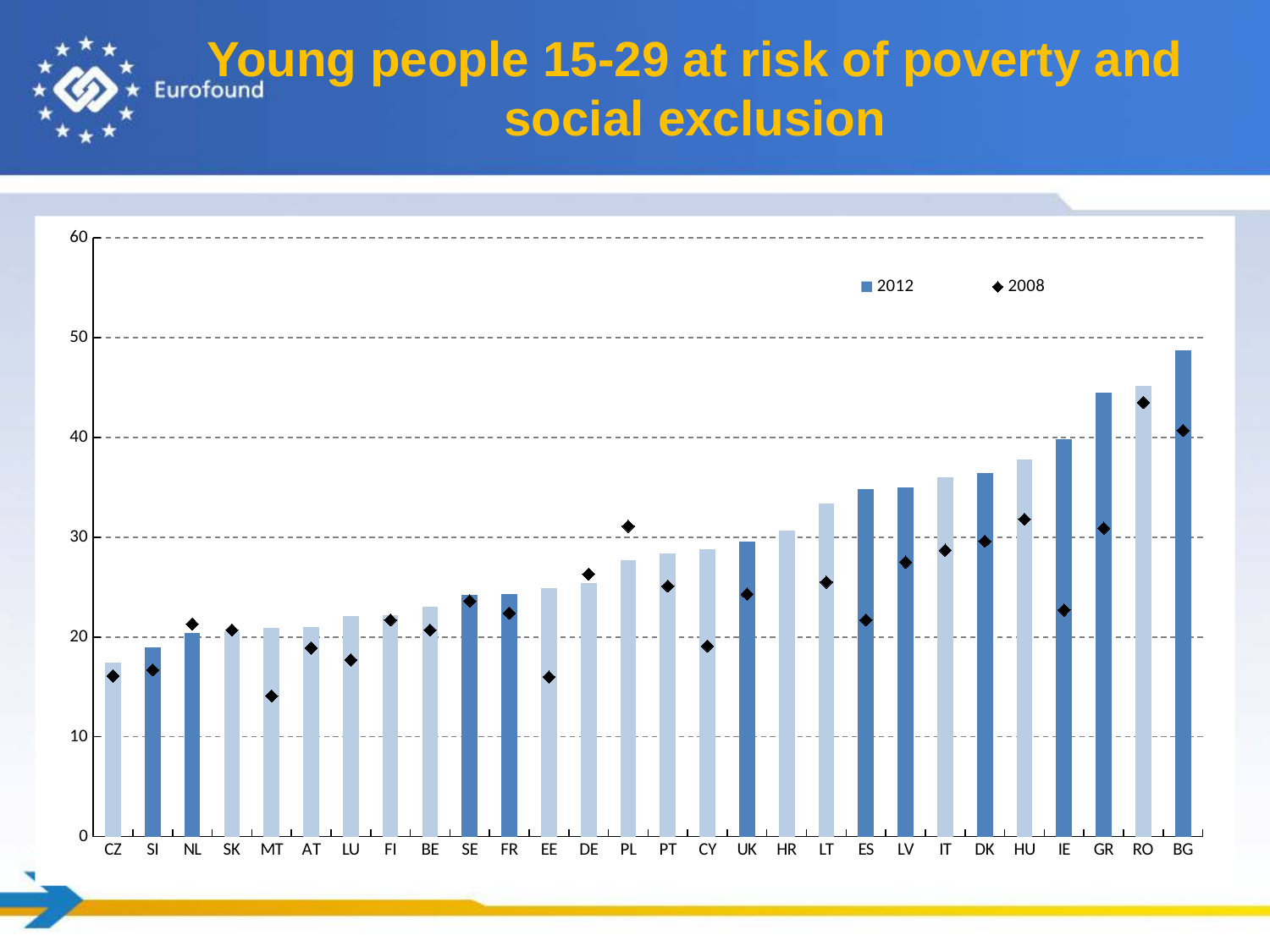
For PL, which is larger: the 2012 bar or the 2008 marker? 2008 Which country has the lowest 2012 bar? CZ How many series does the legend list? 2 Is the 2012 value for CZ greater or less than 20? less Is the 2012 value for DK greater or less than 30? greater How many countries are shown along the x axis? 28 What kind of chart is shown on the slide? bar chart Which country has the highest 2012 bar? BG Is the 2012 value for BG greater or less than 40? greater Which series is shown with diamond markers according to the legend? 2008 Do the 2012 bars generally rise or fall from left to right along the x axis? rise Which country has the lowest 2008 marker? MT